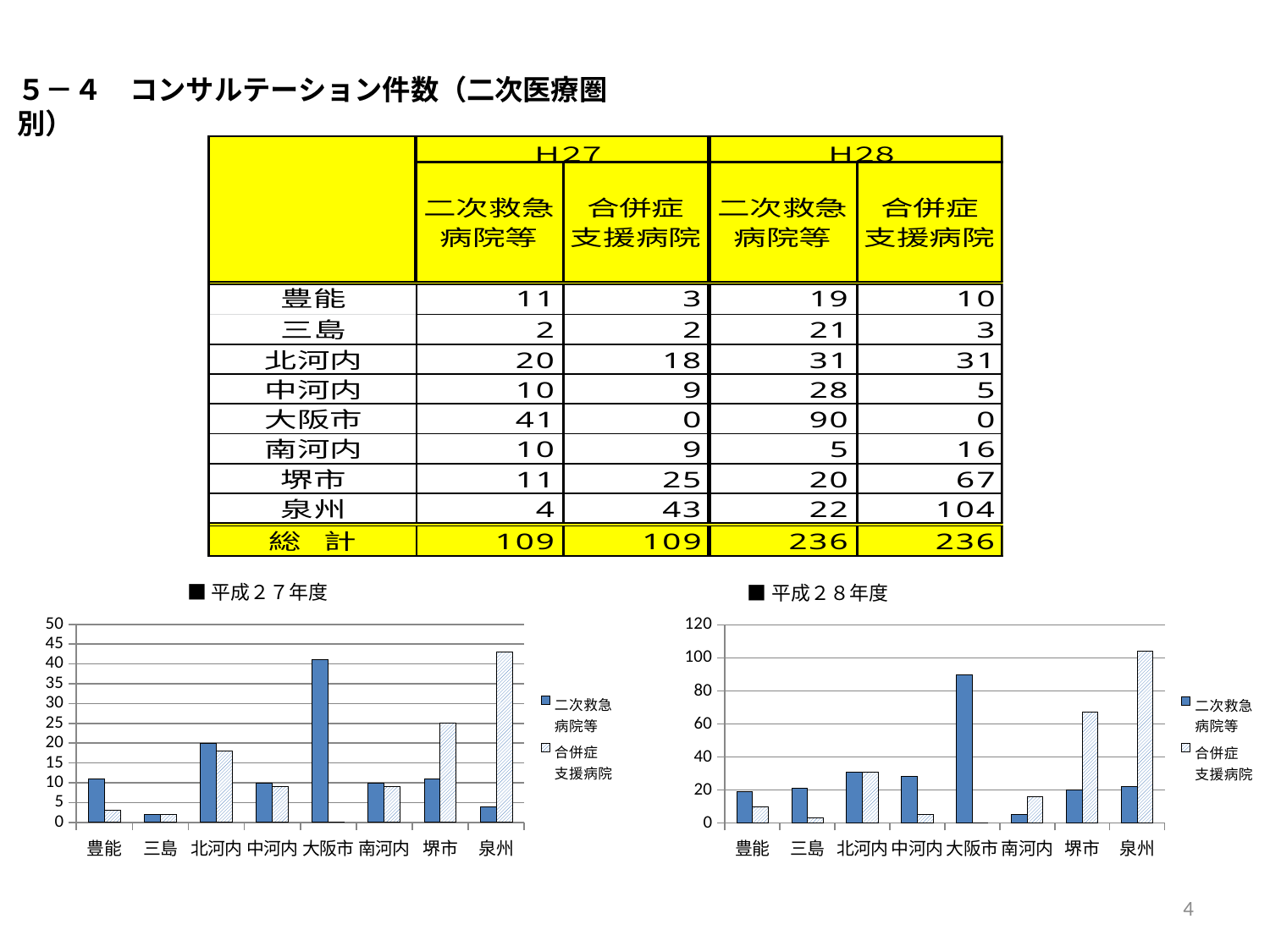
In the 平成28年度 chart, which series has the larger value for 堺市, 二次救急病院等 or 合併症支援病院? 合併症支援病院 In the 平成27年度 chart, which category has the highest value for 二次救急病院等? 大阪市 In the 平成28年度 chart, is the value for 合併症支援病院 in 堺市 greater or less than 60? greater What is the highest tick value on the y axis of the 平成28年度 chart? 120 In the 平成28年度 chart, which category has the highest value for 合併症支援病院? 泉州 How many categories are shown on the x axis of the 平成28年度 chart? 8 In the 平成28年度 chart, what is the difference between the 合併症支援病院 value and the 二次救急病院等 value for 泉州? 82 In the 平成28年度 chart, what is the value for 二次救急病院等 in 大阪市? 90 What kind of chart is the 平成27年度 chart? bar chart In the 平成27年度 chart, is the value for 二次救急病院等 in 大阪市 greater or less than 35? greater How many series does the legend of the 平成27年度 chart list? 2 In the 平成27年度 chart, what is the value for 合併症支援病院 in 泉州? 43